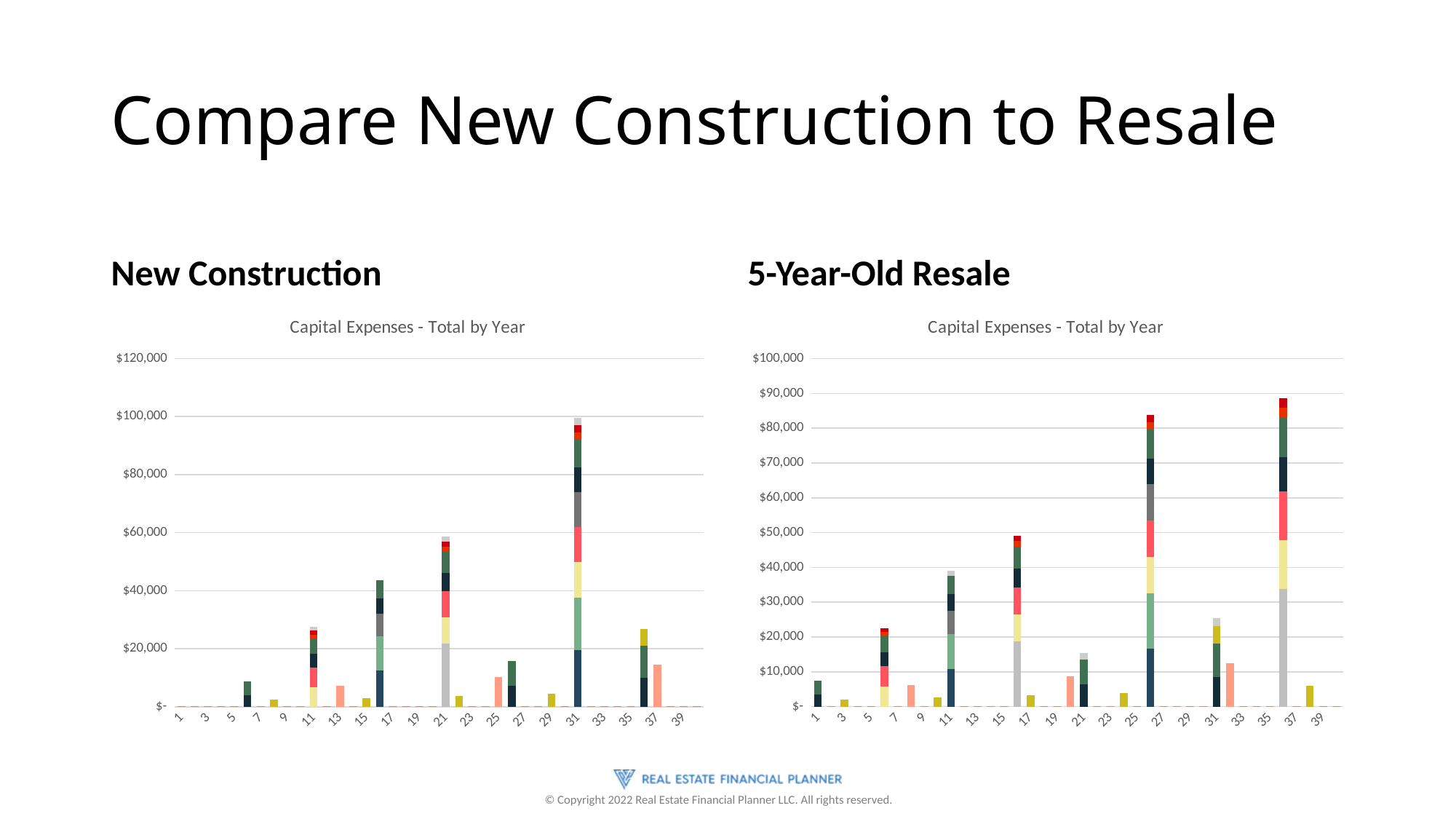
What is the highest value shown on the vertical axis of the New Construction chart? $120,000 In the 5-Year-Old Resale chart, which year has the larger total: year 11 or year 17? 11 What kind of chart is shown under the "New Construction" heading? Bar chart In the 5-Year-Old Resale chart, which year has the highest total capital expenses? 36 In the New Construction chart, is the total for year 21 greater or less than $40,000? greater In the New Construction chart, which year has the larger total: year 21 or year 31? 31 In the 5-Year-Old Resale chart, is the total for year 11 greater or less than $30,000? greater What is the title of the chart under the "5-Year-Old Resale" heading? Capital Expenses - Total by Year In the New Construction chart, which year has the highest total capital expenses? 31 In the New Construction chart, is the total for year 31 greater or less than $80,000? greater